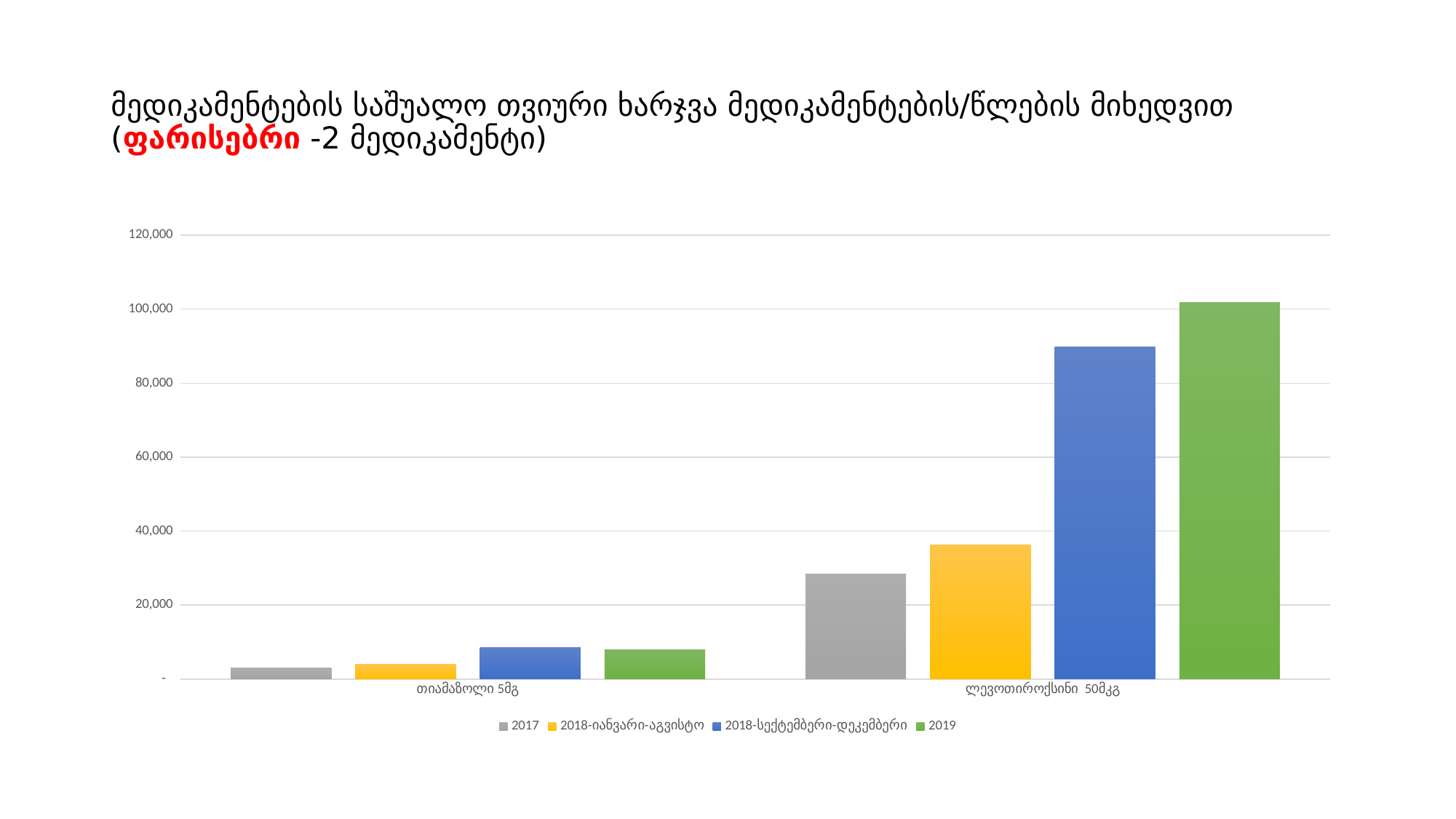
What colour represents the 2019 series in the chart's legend? green How many categories are shown on the x axis of the chart? 2 Is the 2019 value for თიამაზოლი 5მგ greater or less than 20,000? less Which category has the larger 2017 value, თიამაზოლი 5მგ or ლევოთიროქსინი 50მკგ? ლევოთიროქსინი 50მკგ For ლევოთიროქსინი 50მკგ, do the values rise or fall from the 2017 series to the 2019 series? rise How many series does the chart's legend list? 4 Which series has the highest value for ლევოთიროქსინი 50მკგ? 2019 Is the 2017 value for ლევოთიროქსინი 50მკგ greater or less than 20,000? greater Is the 2018-სექტემბერი-დეკემბერი value for ლევოთიროქსინი 50მკგ greater or less than 80,000? greater What kind of chart is shown on the slide? bar chart Which series has the lowest value for ლევოთიროქსინი 50მკგ? 2017